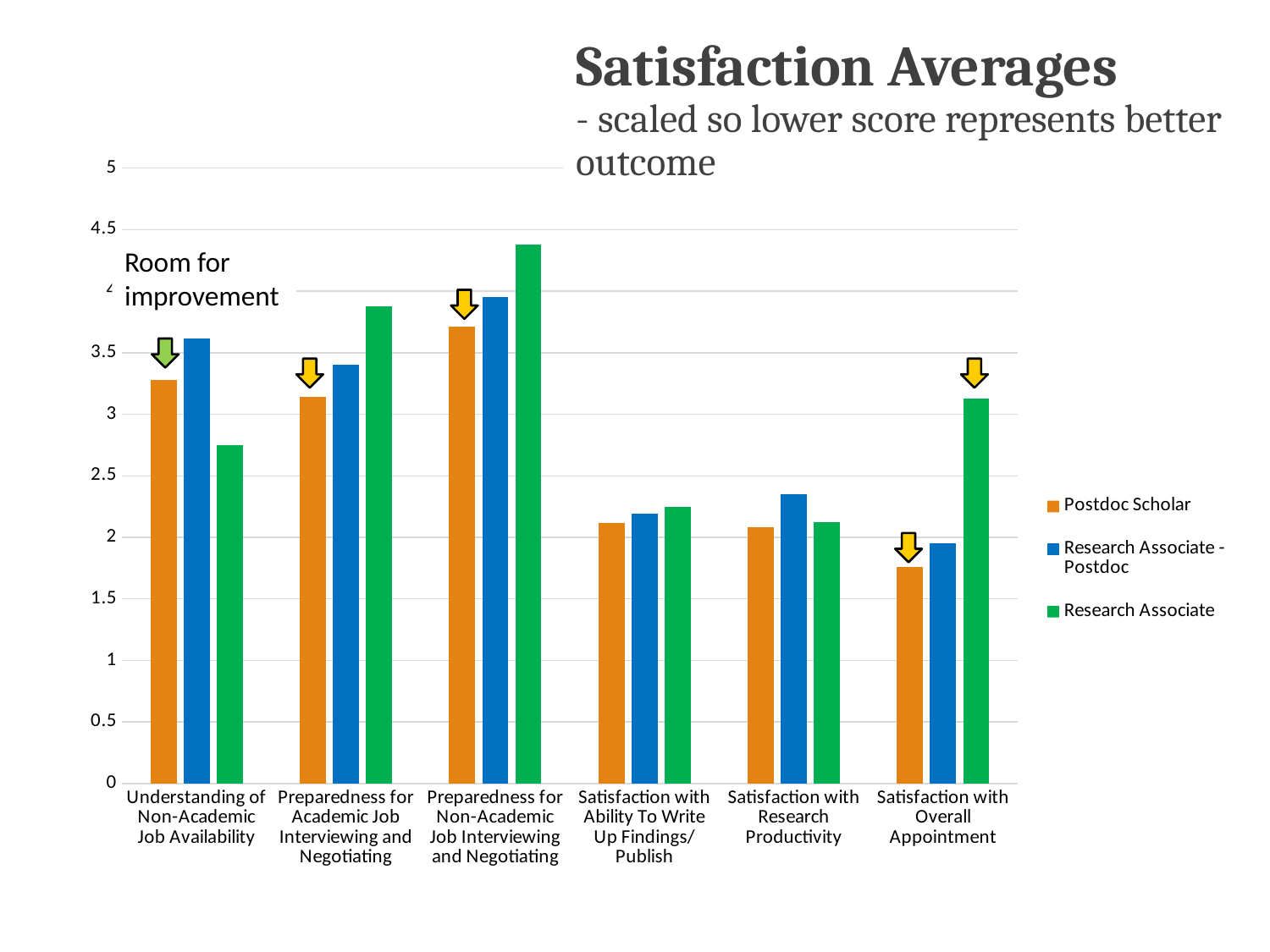
For Understanding of Non-Academic Job Availability, which is larger: Research Associate - Postdoc or Research Associate? Research Associate - Postdoc For Satisfaction with Research Productivity, which series has the highest bar? Research Associate - Postdoc How many series does the legend list? 3 Is the Postdoc Scholar value for Satisfaction with Overall Appointment greater or less than 2? less For Satisfaction with Overall Appointment, which is larger: Postdoc Scholar or Research Associate? Research Associate Which series has the lowest bar in the whole chart, and for which category? Postdoc Scholar, Satisfaction with Overall Appointment How many categories are shown along the x axis? 6 Is the Research Associate value for Understanding of Non-Academic Job Availability greater or less than 3? less Which series has the tallest bar in the whole chart, and for which category? Research Associate, Preparedness for Non-Academic Job Interviewing and Negotiating Is the Research Associate value for Preparedness for Non-Academic Job Interviewing and Negotiating greater or less than 4? greater What is the title of the chart on the slide? Satisfaction Averages What kind of chart is shown on the slide? Bar chart